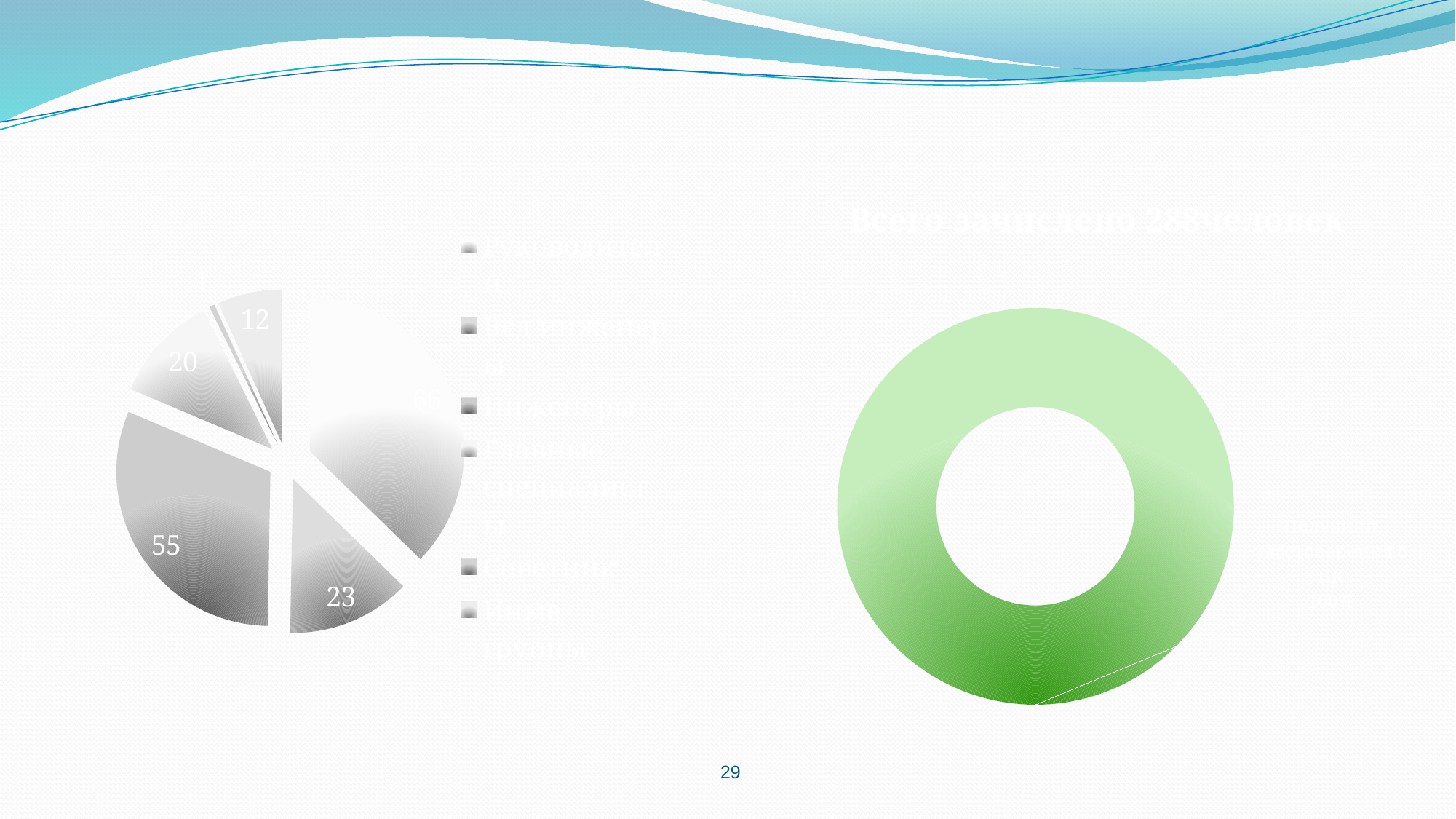
What kind of chart is shown on the right side of the slide? doughnut chart In the pie chart on the left, what is the smallest data label value? 1 In the pie chart on the left, which is larger: the slice labelled 20 or the slice labelled 23? 23 In the pie chart on the left, what is the difference between the slice labelled 23 and the slice labelled 12? 11 In the pie chart on the left, how many slices are there? 6 What colour is the doughnut chart on the right side of the slide? green What kind of chart is shown on the left side of the slide? pie chart In the pie chart on the left, what is the largest data label value? 66 How many entries does the legend of the pie chart on the left list? 6 In the pie chart on the left, what is the difference between the largest slice (66) and the second largest slice (55)? 11 In the pie chart on the left, what is the sum of all the slice data labels? 177